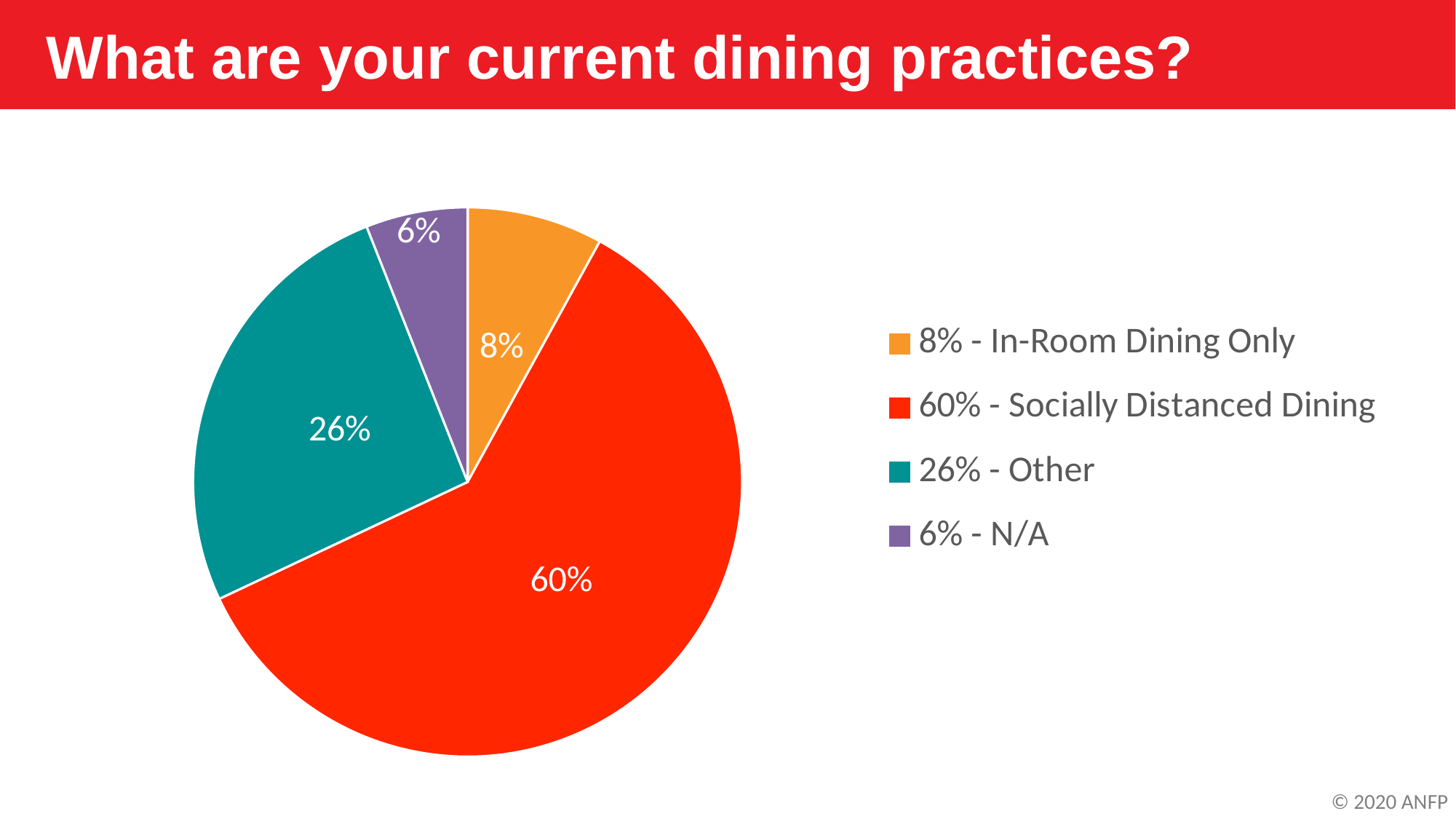
Which category has the largest slice of the pie? Socially Distanced Dining Which category has the smallest slice of the pie? N/A How many entries does the legend list? 4 What share of the pie is Socially Distanced Dining? 60% What share of the pie is N/A? 6% Which is larger, the In-Room Dining Only share or the N/A share? In-Room Dining Only What is the difference between the Socially Distanced Dining share and the Other share? 34% What colour is the slice for Other? teal How many slices does the pie chart have? 4 What share of the pie is In-Room Dining Only? 8% What kind of chart is shown on the slide? pie chart